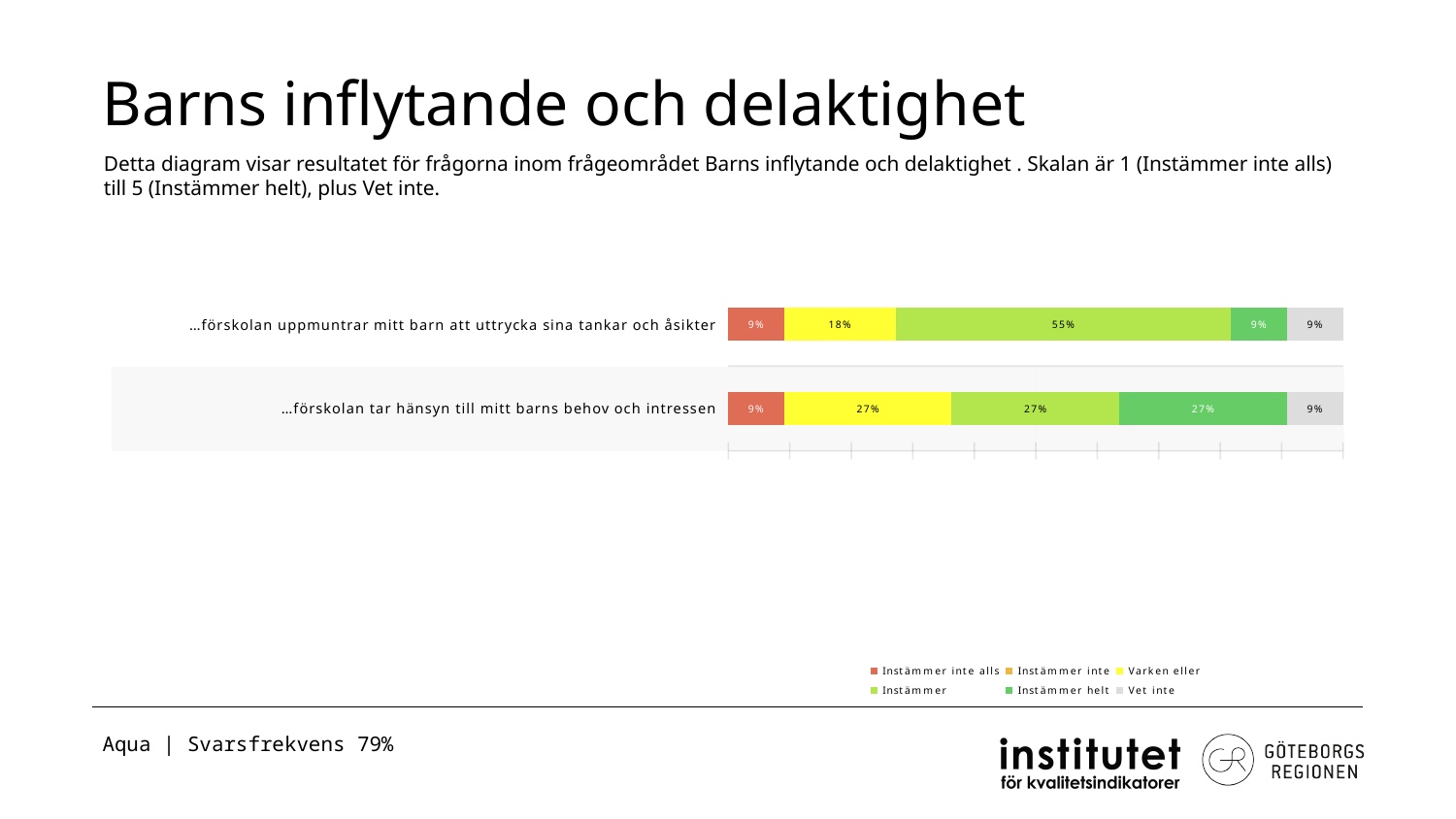
What is the 'Varken eller' share for '…förskolan uppmuntrar mitt barn att uttrycka sina tankar och åsikter'? 18% What is the title of the slide containing the chart? Barns inflytande och delaktighet What is the 'Vet inte' share for '…förskolan tar hänsyn till mitt barns behov och intressen'? 9% How many series does the chart legend list? 6 What is the 'Instämmer helt' share for '…förskolan tar hänsyn till mitt barns behov och intressen'? 27% What kind of chart is shown on the slide? Stacked bar chart Which question has the highest 'Instämmer' share? …förskolan uppmuntrar mitt barn att uttrycka sina tankar och åsikter What is the 'Instämmer' share for '…förskolan uppmuntrar mitt barn att uttrycka sina tankar och åsikter'? 55% Which question has the larger 'Instämmer helt' share? …förskolan tar hänsyn till mitt barns behov och intressen What is the difference in the 'Instämmer' share between '…förskolan uppmuntrar mitt barn att uttrycka sina tankar och åsikter' and '…förskolan tar hänsyn till mitt barns behov och intressen'? 28 percentage points How many questions (categories) are plotted in the chart? 2 What is the 'Varken eller' share for '…förskolan tar hänsyn till mitt barns behov och intressen'? 27%